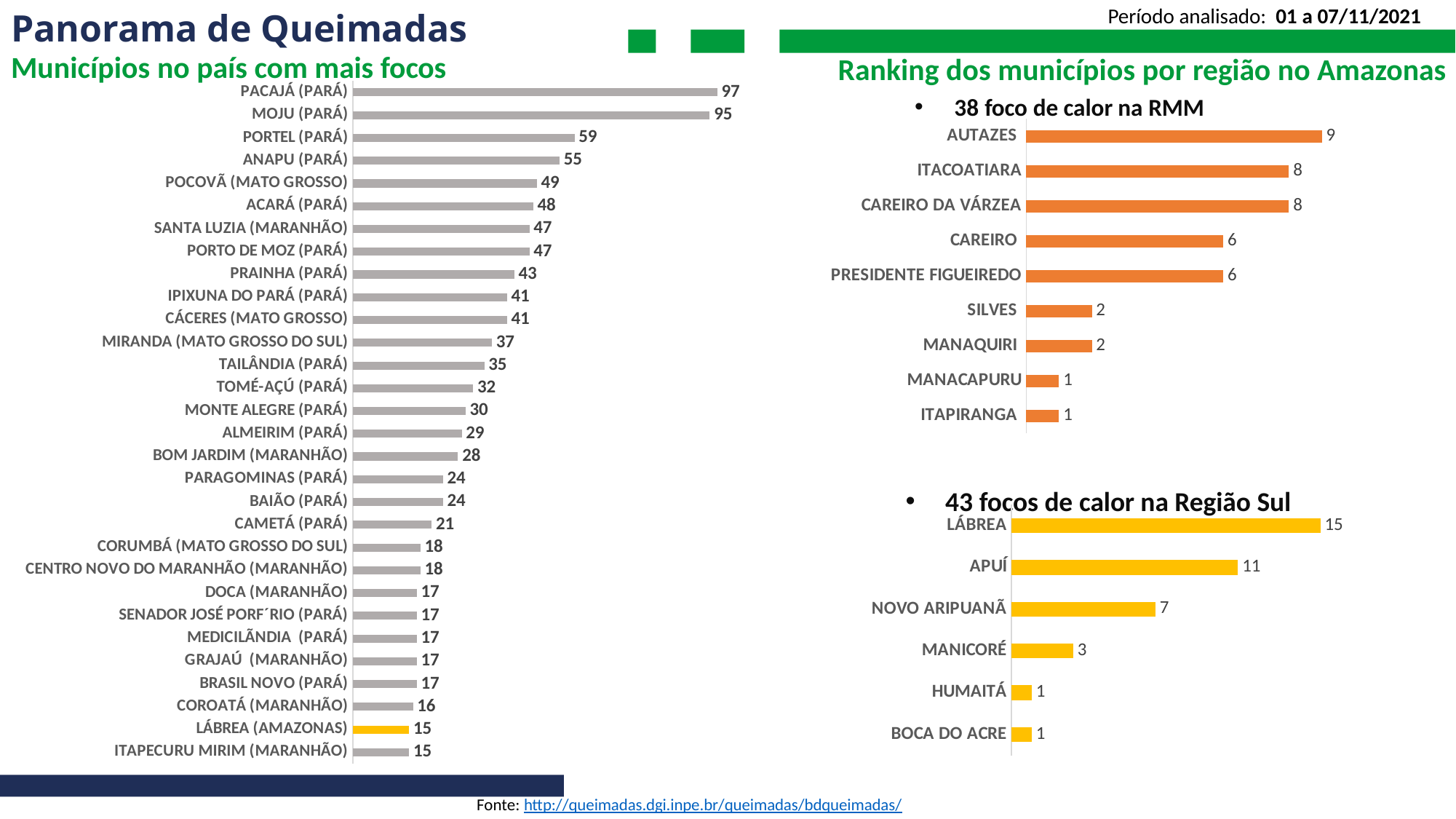
In the chart '38 foco de calor na RMM', what is the value for CAREIRO DA VÁRZEA? 8 In the chart 'Municípios no país com mais focos', what is the value for LÁBREA (AMAZONAS)? 15 In the chart 'Municípios no país com mais focos', what is the difference between the values for PACAJÁ (PARÁ) and MOJU (PARÁ)? 2 In the chart 'Municípios no país com mais focos', which has a larger value, PORTEL (PARÁ) or POCOVÃ (MATO GROSSO)? PORTEL (PARÁ) How many municipalities are listed in the chart 'Municípios no país com mais focos'? 30 In the chart '43 focos de calor na Região Sul', what is the difference between the values for LÁBREA and NOVO ARIPUANÃ? 8 In the chart 'Municípios no país com mais focos', what is the value for PACAJÁ (PARÁ)? 97 In the chart '43 focos de calor na Região Sul', what is the value for APUÍ? 11 What type of chart is '43 focos de calor na Região Sul'? Bar chart In the chart 'Municípios no país com mais focos', which bar is coloured yellow instead of grey? LÁBREA (AMAZONAS) How many municipalities are shown in the chart '38 foco de calor na RMM'? 9 In the chart '38 foco de calor na RMM', which municipality has the highest value? AUTAZES